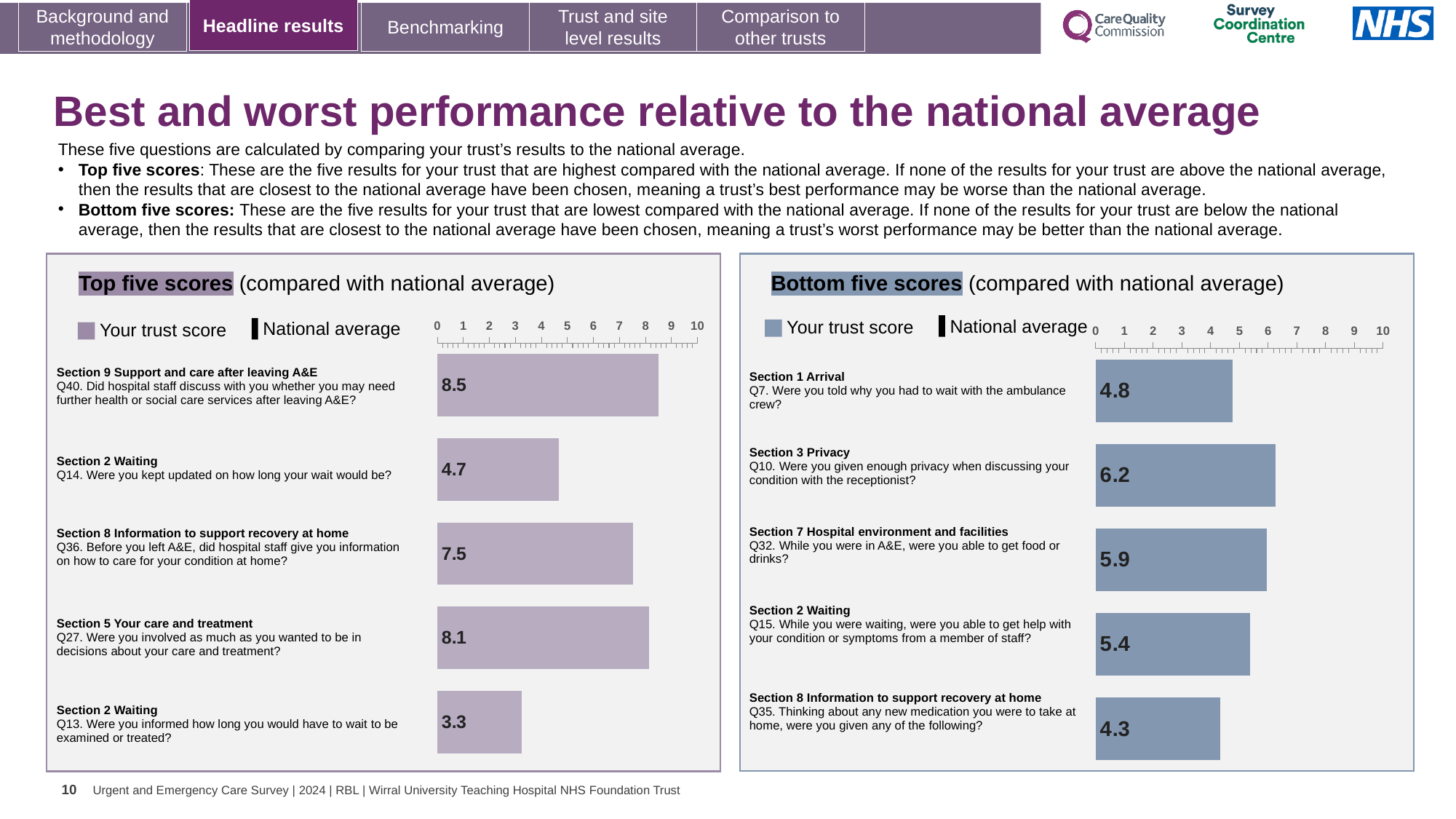
In the Top five scores chart, which question has the lowest trust score? Q13. Were you informed how long you would have to wait to be examined or treated? In the Top five scores chart, what is the trust score for Q40 (Support and care after leaving A&E)? 8.5 In the Bottom five scores chart, is the trust score for Q7 greater or less than 5? less In the Top five scores chart, what is the difference between the trust scores for Q40 and Q13? 5.2 In the Bottom five scores chart, what is the difference between the trust scores for Q10 and Q35? 1.9 In the Bottom five scores chart, which question has the highest trust score? Q10. Were you given enough privacy when discussing your condition with the receptionist? How many bars are shown in the Top five scores chart? 5 In the Bottom five scores chart, which question has the lowest trust score? Q35. Thinking about any new medication you were to take at home, were you given any of the following? In the Bottom five scores chart, what is the trust score for Q10 (privacy when discussing your condition with the receptionist)? 6.2 In the Top five scores chart, which has the larger trust score: Q36 or Q27? Q27 How many entries does the legend of the Top five scores chart list? 2 What type of chart is used in the Bottom five scores panel? Bar chart